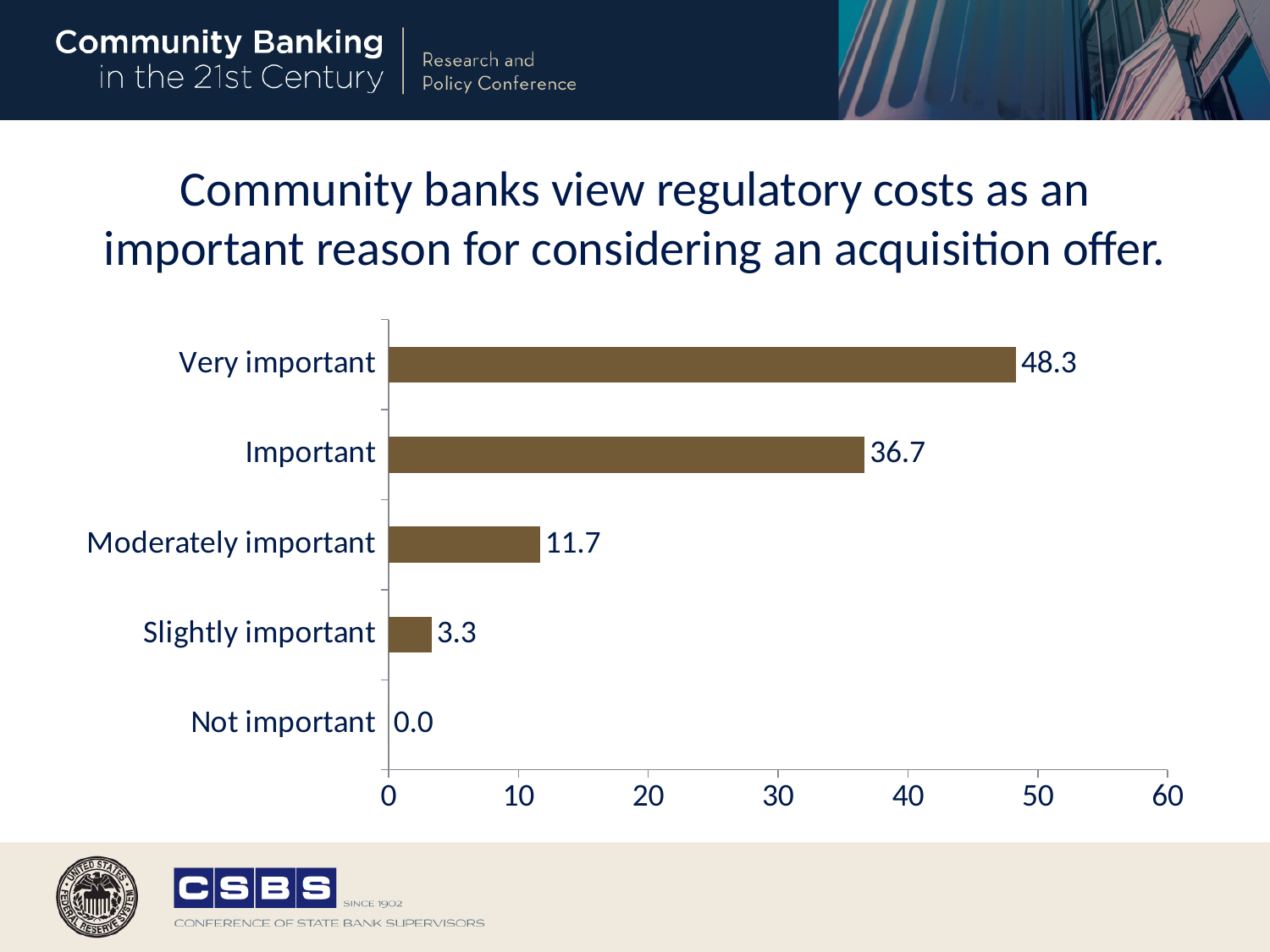
What is the value for Slightly important? 3.3 What is the value for Important? 36.7 Which category has the highest value? Very important What kind of chart is shown on the slide? Bar chart What is the difference between the values for Very important and Important? 11.6 How many categories are shown in the chart? 5 What is the highest value shown on the horizontal axis? 60 What is the value for Moderately important? 11.7 Which category has the lowest value? Not important What is the value for Not important? 0.0 What is the value for Very important? 48.3 Which is larger, the value for Moderately important or the value for Slightly important? Moderately important